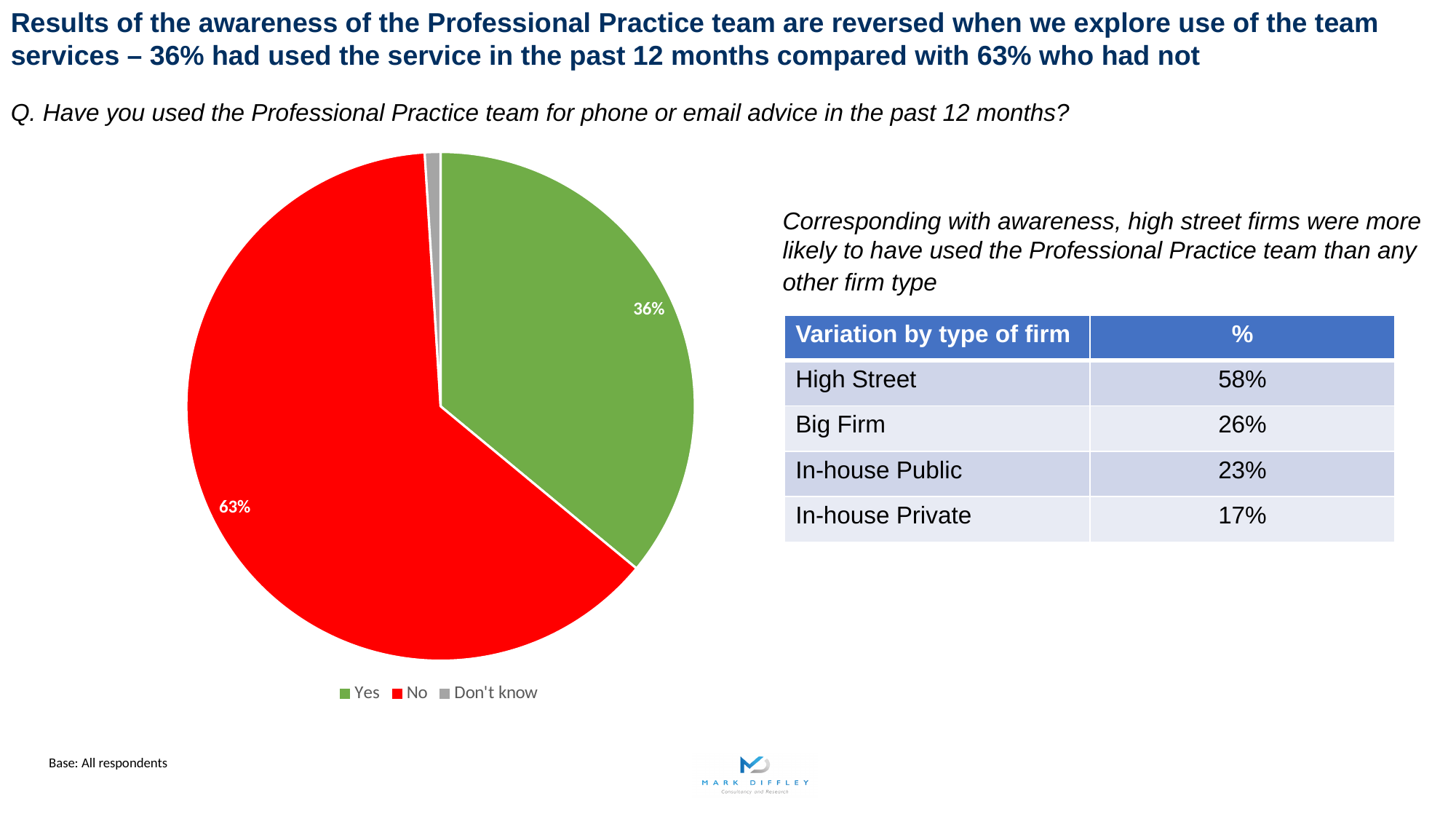
Which response has the smallest slice in the pie chart? Don't know What percentage of respondents answered No in the pie chart? 63% Is the Yes slice greater or less than half of the pie? less What is the difference in percentage points between the No and Yes slices? 27 What kind of chart is shown on the slide? Pie chart Which slice is larger in the pie chart, Yes or No? No How many categories does the pie chart legend list? 3 What percentage of respondents answered Yes in the pie chart? 36% Which response has the largest slice in the pie chart? No What colour is the No slice in the pie chart? Red What colour is the Yes slice in the pie chart? Green